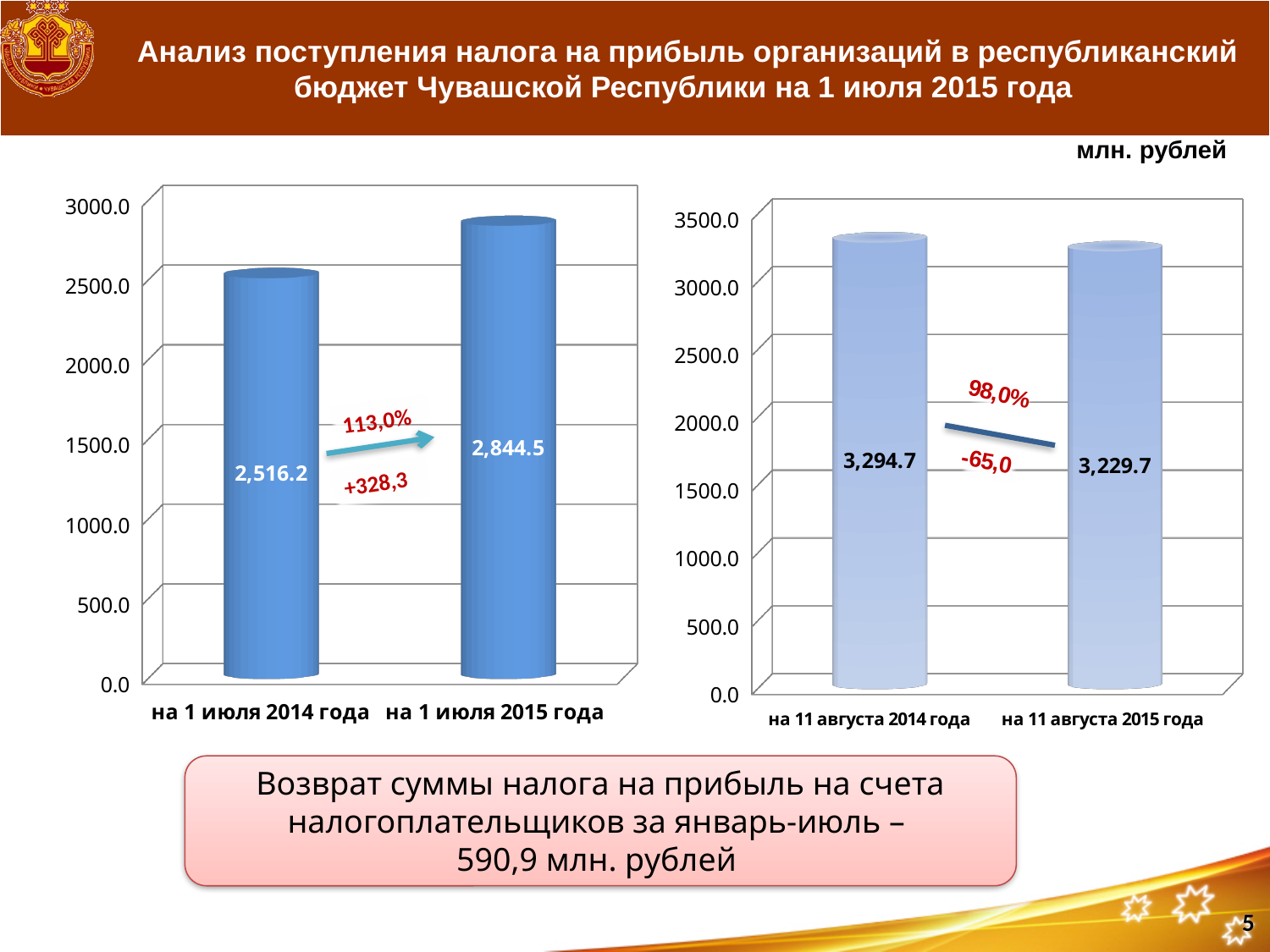
On the left chart, which category has the higher value? на 1 июля 2015 года On the left chart, what is the difference between the 2015 and 2014 values? 328.3 On the left chart, do the values rise or fall from 2014 to 2015? rise On the right chart, what is the value for 11 August 2014 (на 11 августа 2014 года)? 3,294.7 On the left chart, what is the value for 1 July 2015 (на 1 июля 2015 года)? 2,844.5 On the right chart, which category has the lower value? на 11 августа 2015 года On the left chart, what is the value for 1 July 2014 (на 1 июля 2014 года)? 2,516.2 On the left chart, what percentage is shown on the arrow between the two bars? 113,0% What type of chart is the right chart? bar chart On the right chart, what is the value for 11 August 2015 (на 11 августа 2015 года)? 3,229.7 On the right chart, is the value for 11 August 2014 greater or less than 3000.0? greater On the right chart, what is the difference between the 2014 and 2015 values? 65.0